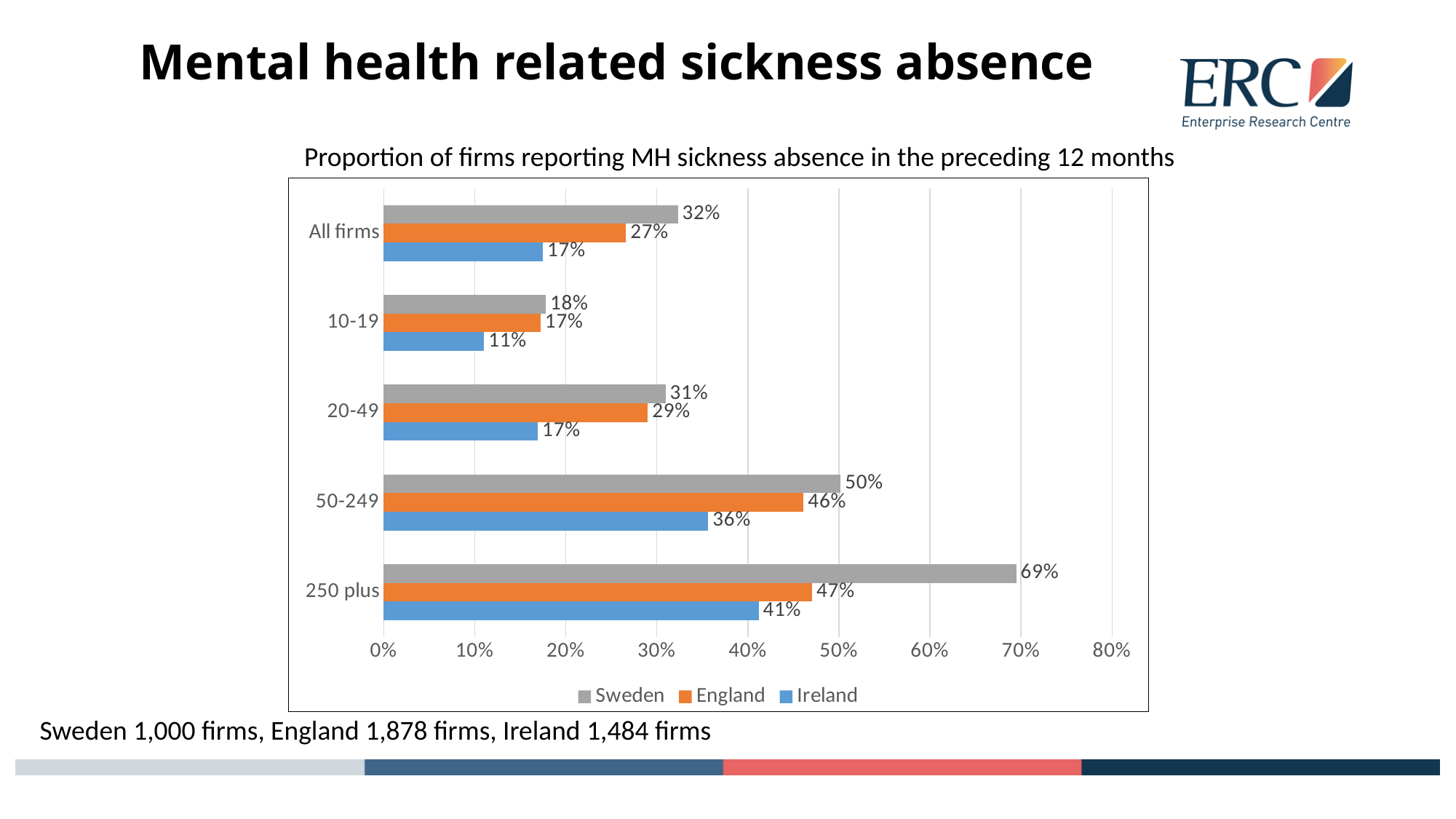
What is the value for England for All firms? 27% Which firm size category has the highest value for Sweden? 250 plus What proportion of firms in Sweden with 250 plus employees reported MH sickness absence? 69% What is the difference between England and Ireland in the 20-49 category? 12% What is the value for Ireland in the 50-249 category? 36% Which is larger in the 50-249 category, Sweden or England? Sweden Which colour represents England in the chart? Orange What is the difference between Sweden and Ireland in the 250 plus category? 28% Which firm size category has the lowest value for Ireland? 10-19 How many series does the legend list? 3 What kind of chart is shown on the slide? Bar chart How many firm size categories are shown on the chart? 5